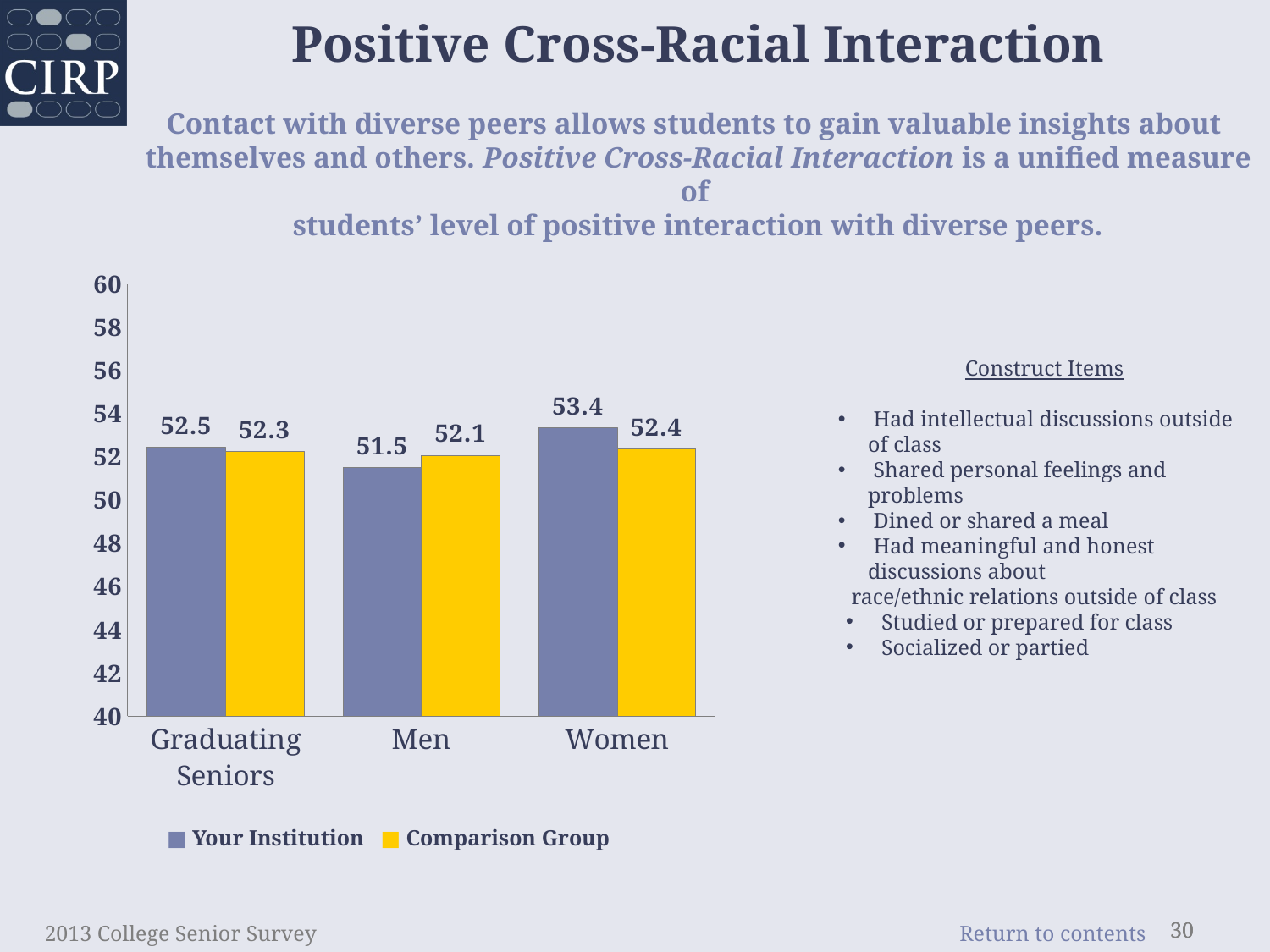
What is the value for Your Institution for Graduating Seniors? 52.5 Which category has the lowest value for Your Institution? Men How many categories are shown on the x axis? 3 What is the difference between Your Institution and Comparison Group for Men? 0.6 For Men, which is larger: Your Institution or Comparison Group? Comparison Group What is the difference between Your Institution and Comparison Group for Women? 1.0 Which category has the highest value for Your Institution? Women What is the value for Comparison Group for Men? 52.1 What kind of chart is shown on the slide? bar chart What is the title of the slide's chart? Positive Cross-Racial Interaction What is the value for Your Institution for Women? 53.4 How many series does the legend list? 2